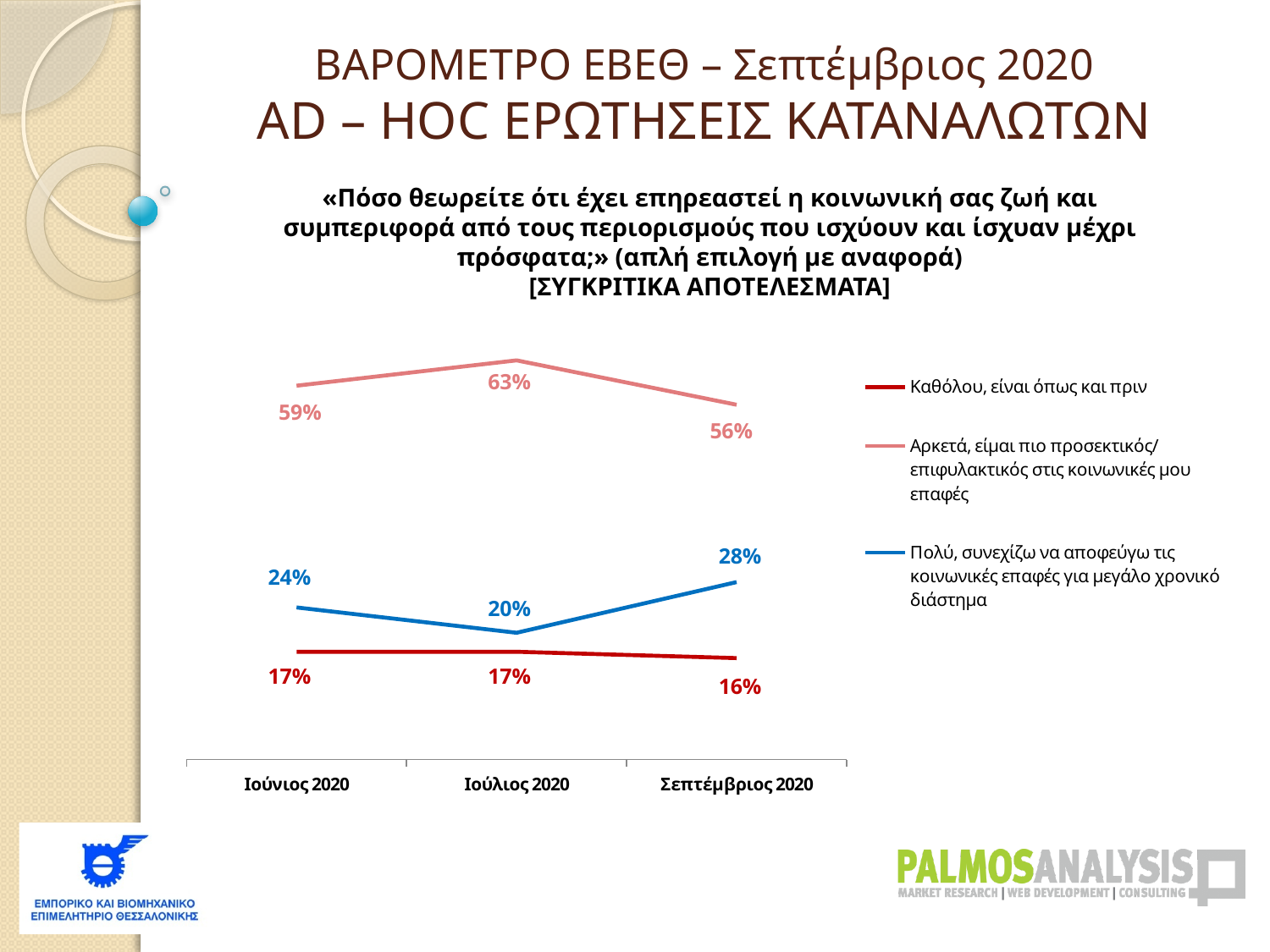
What colour is the line for 'Καθόλου, είναι όπως και πριν'? red What is the difference between the 'Αρκετά' series values in Ιούλιος 2020 and Σεπτέμβριος 2020? 7% What is the value for 'Αρκετά, είμαι πιο προσεκτικός/επιφυλακτικός στις κοινωνικές μου επαφές' in Ιούλιος 2020? 63% Which series has the larger value in Σεπτέμβριος 2020: 'Πολύ, συνεχίζω να αποφεύγω τις κοινωνικές επαφές' or 'Καθόλου, είναι όπως και πριν'? Πολύ, συνεχίζω να αποφεύγω τις κοινωνικές επαφές για μεγάλο χρονικό διάστημα In which month does the 'Αρκετά, είμαι πιο προσεκτικός/επιφυλακτικός στις κοινωνικές μου επαφές' series reach its highest value? Ιούλιος 2020 What is the value for 'Καθόλου, είναι όπως και πριν' in Ιούνιος 2020? 17% How many series does the legend list? 3 What type of chart is shown on the slide? line chart Does the 'Καθόλου, είναι όπως και πριν' series rise or fall from Ιούλιος 2020 to Σεπτέμβριος 2020? fall In which month does the 'Πολύ, συνεχίζω να αποφεύγω τις κοινωνικές επαφές για μεγάλο χρονικό διάστημα' series have its lowest value? Ιούλιος 2020 What is the value for 'Πολύ, συνεχίζω να αποφεύγω τις κοινωνικές επαφές για μεγάλο χρονικό διάστημα' in Σεπτέμβριος 2020? 28% How many time points are shown on the x axis? 3